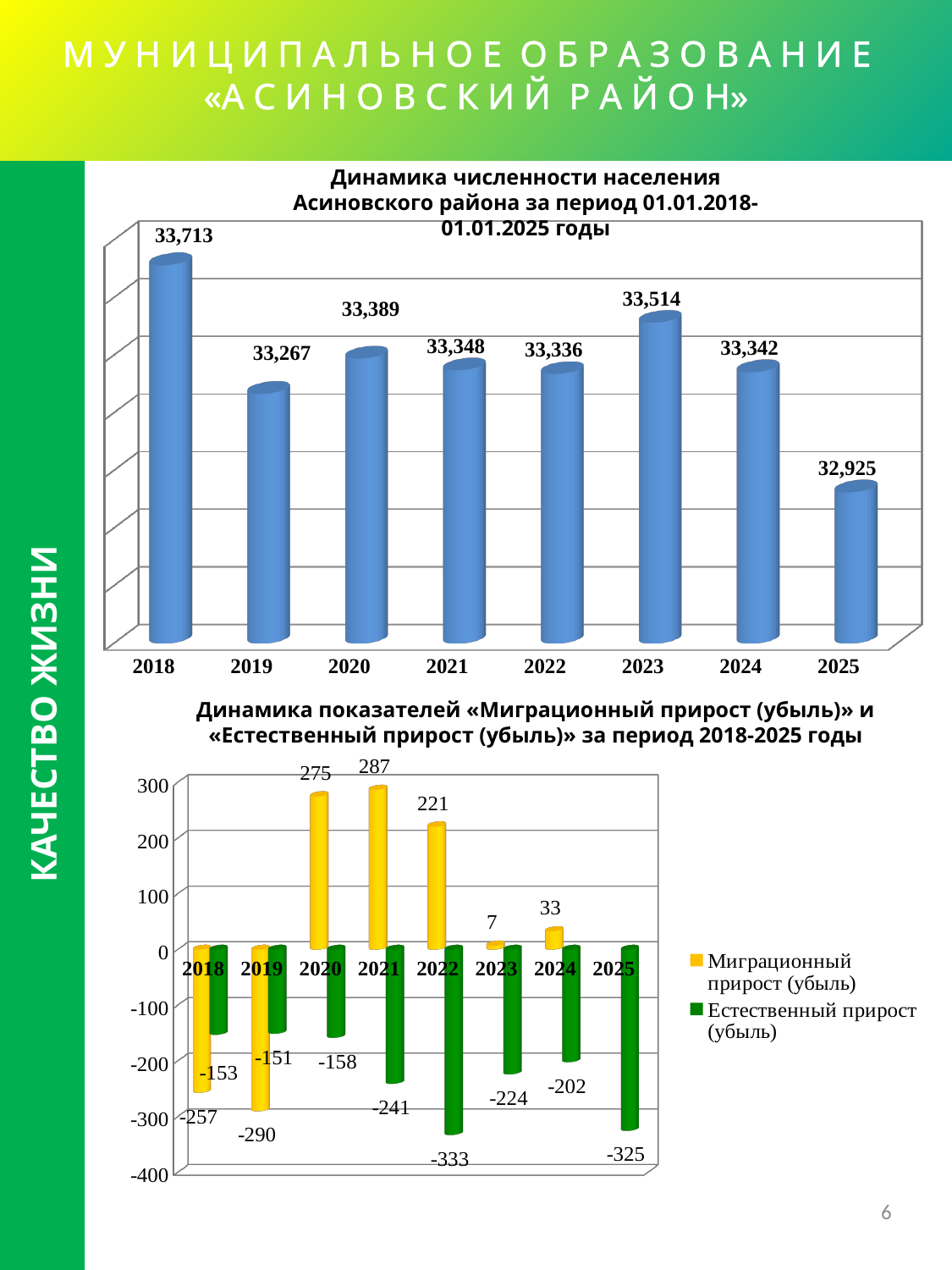
In the top chart (population dynamics), how many years are shown? 8 In the top chart (population dynamics), which year has the lowest population? 2025 In the top chart (population dynamics), which year has the highest population? 2018 In the bottom chart (migration and natural growth), what is the value of «Естественный прирост (убыль)» for 2022? -333 In the top chart (population dynamics), what is the population value for 2018? 33,713 In the top chart (population dynamics), what is the population value for 2025? 32,925 In the bottom chart (migration and natural growth), what is the value of «Миграционный прирост (убыль)» for 2021? 287 In the bottom chart (migration and natural growth), in which year is «Естественный прирост (убыль)» lowest? 2022 What type of chart is the top chart (population dynamics)? Bar chart In the bottom chart (migration and natural growth), how many series does the legend list? 2 In the top chart (population dynamics), which is larger: the value for 2023 or the value for 2024? 2023 In the top chart (population dynamics), what is the difference between the 2018 and 2025 population values? 788